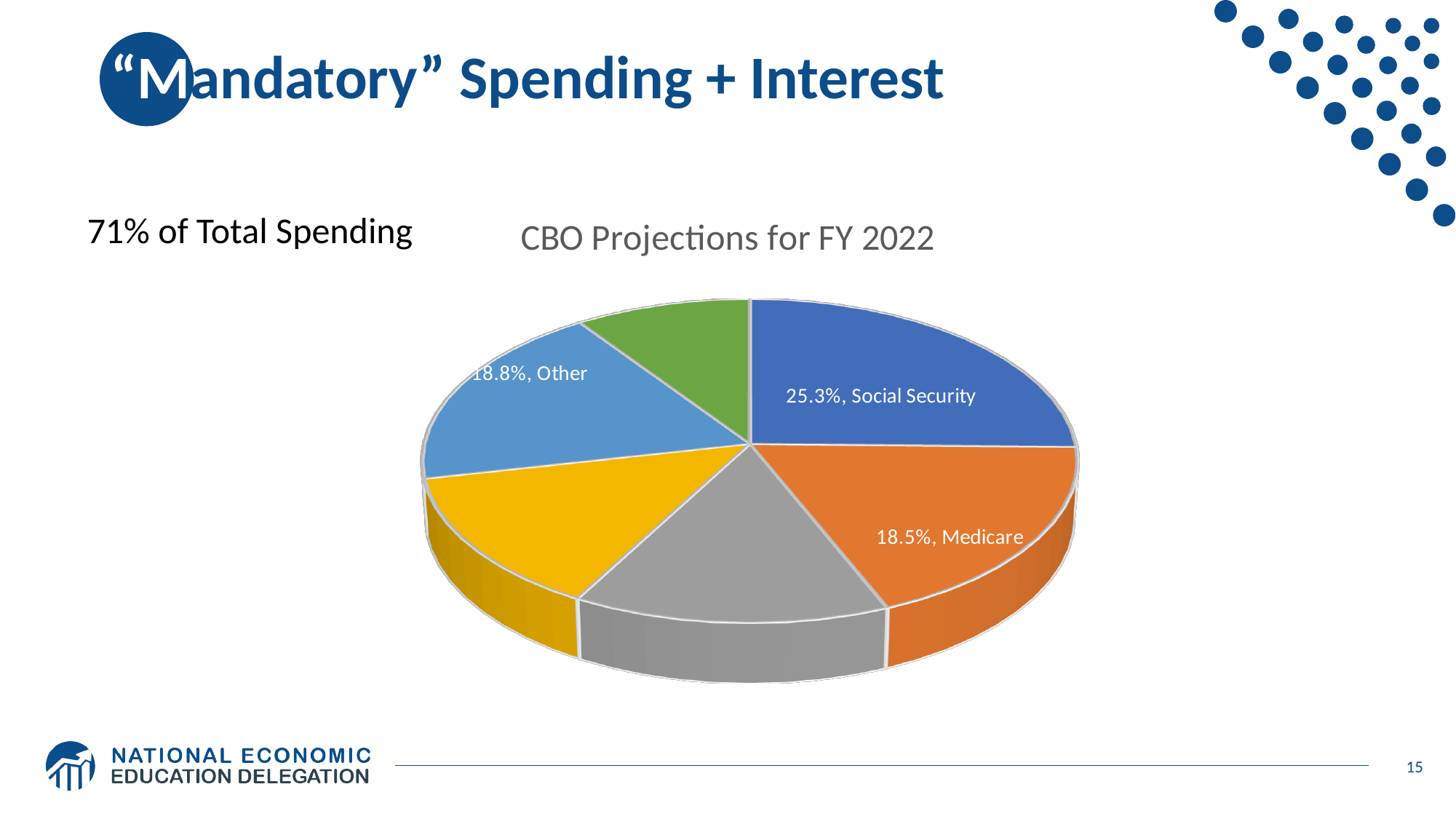
Is the Social Security slice greater or less than 25% of the pie? greater What colour is the Social Security slice? Blue What is the title of the pie chart? CBO Projections for FY 2022 What is the difference in percentage points between the Social Security slice and the Medicare slice? 6.8 What share of the pie is labeled for Other? 18.8% What is the difference in percentage points between the Other slice and the Medicare slice? 0.3 What share of the pie is labeled for Medicare? 18.5% Which is larger according to the printed labels, the Other slice or the Medicare slice? Other What share of the pie is labeled for Social Security? 25.3% What kind of chart is shown on the slide? Pie chart Which slice of the pie chart is the largest? Social Security How many slices does the pie chart have? 6